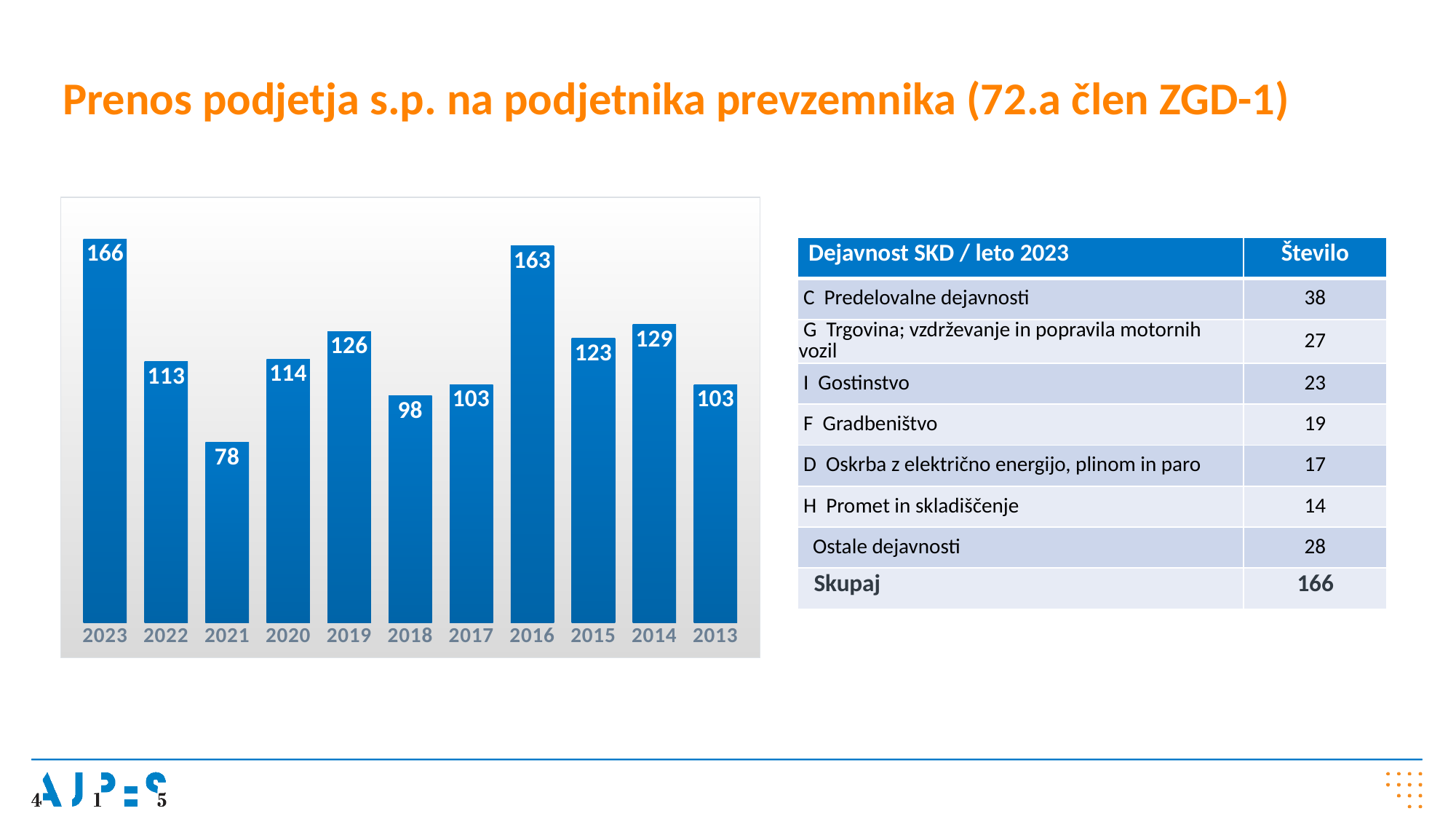
Which is larger in the bar chart, the value for 2019 or the value for 2018? 2019 How many years are shown in the bar chart? 11 What is the value for 2016 in the bar chart? 163 What is the value for 2021 in the bar chart? 78 What is the difference between the values for 2016 and 2015 in the bar chart? 40 What kind of chart is shown on the slide? bar chart Which year has the highest value in the bar chart? 2023 What is the difference between the values for 2023 and 2022 in the bar chart? 53 Which two years in the bar chart share the same value of 103? 2017 and 2013 What is the value for 2023 in the bar chart? 166 Which is larger in the bar chart, the value for 2014 or the value for 2020? 2014 Which year has the lowest value in the bar chart? 2021